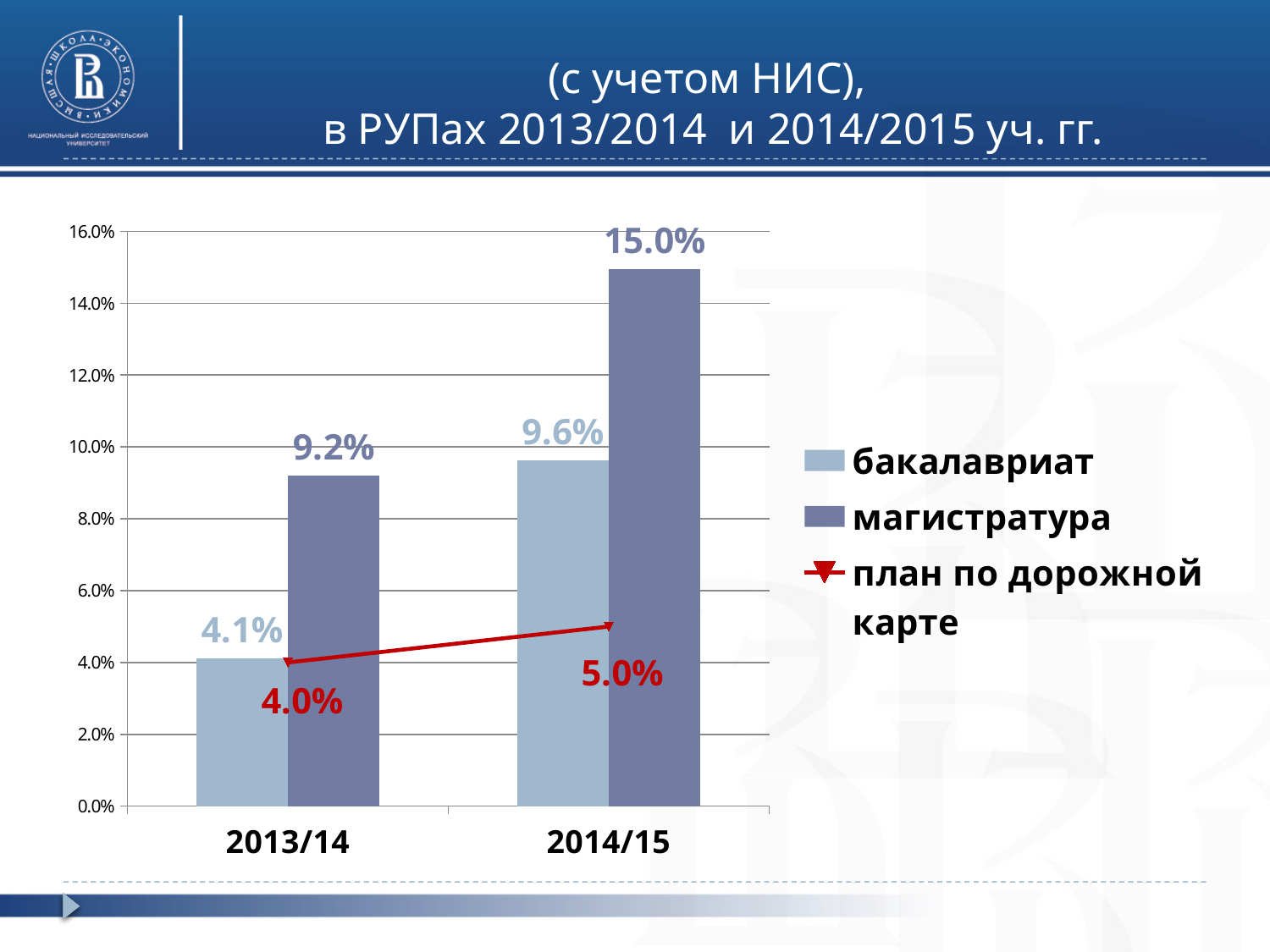
How many categories are shown on the x axis? 2 What is the difference between the магистратура values for 2014/15 and 2013/14? 5.8% How many series does the legend list? 3 What is the value for магистратура in 2014/15? 15.0% Does the бакалавриат value rise or fall from 2013/14 to 2014/15? rise What colour is the план по дорожной карте line? red What is the value for магистратура in 2013/14? 9.2% Which is larger in 2013/14: бакалавриат or магистратура? магистратура What is the difference between магистратура and бакалавриат in 2014/15? 5.4% Which category has the highest value for магистратура? 2014/15 What is the value of план по дорожной карте for 2014/15? 5.0% What is the value for бакалавриат in 2013/14? 4.1%